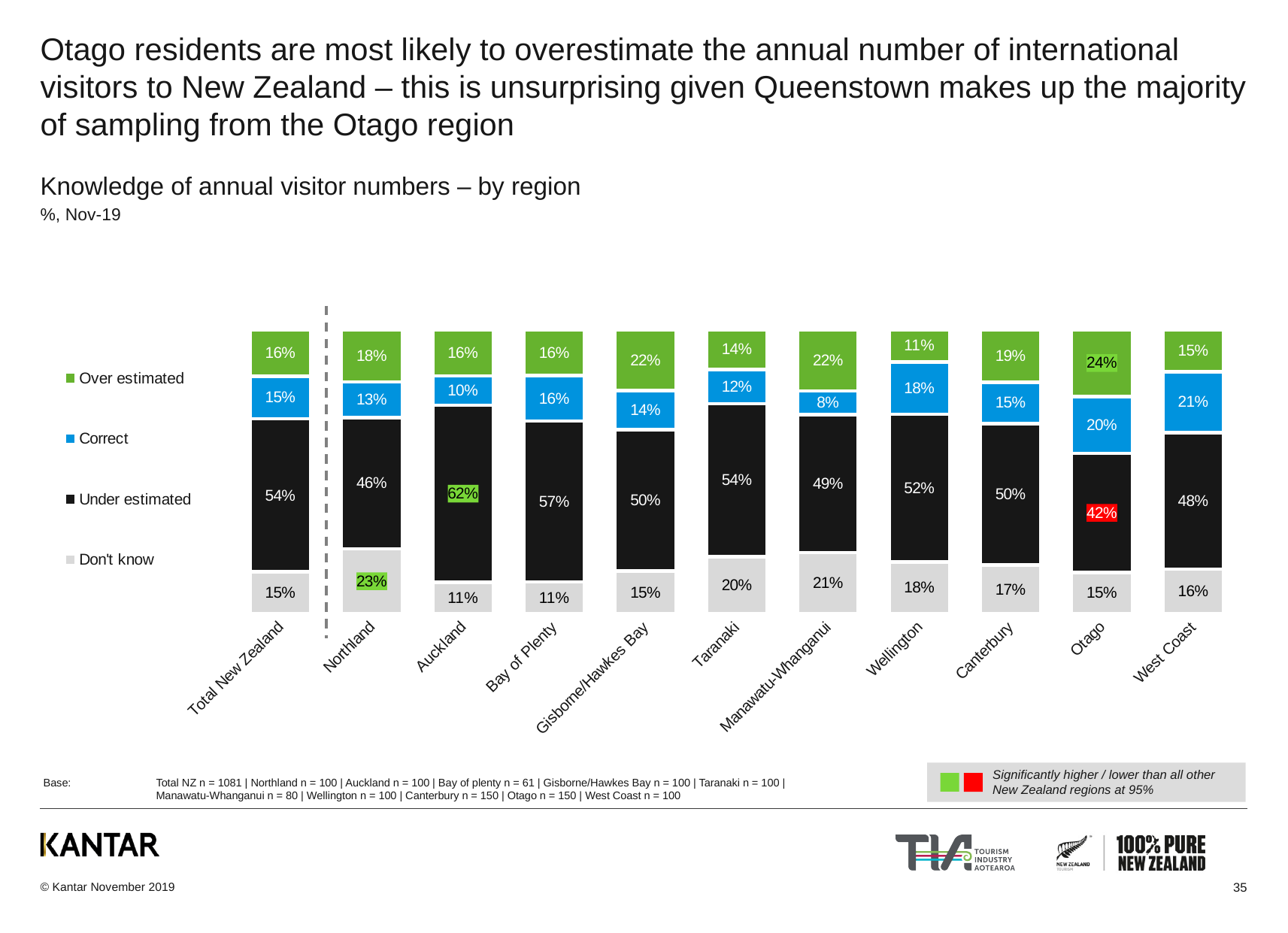
What percentage of Otago residents over estimated the annual number of international visitors? 24% Which region has the highest 'Don't know' percentage? Northland How many regions (including Total New Zealand) are shown on the x axis? 11 Which region has the lowest 'Correct' percentage? Manawatu-Whanganui Which region has the lowest 'Under estimated' percentage? Otago How many series does the legend list? 4 Which has a higher 'Correct' percentage, West Coast or Wellington? West Coast What is the difference in percentage points between the 'Under estimated' values for Auckland and Otago? 20 What is the 'Under estimated' value for Auckland? 62% What type of chart is shown on the slide? Stacked bar chart What is the 'Correct' value for Manawatu-Whanganui? 8% Which region has the highest 'Over estimated' percentage? Otago